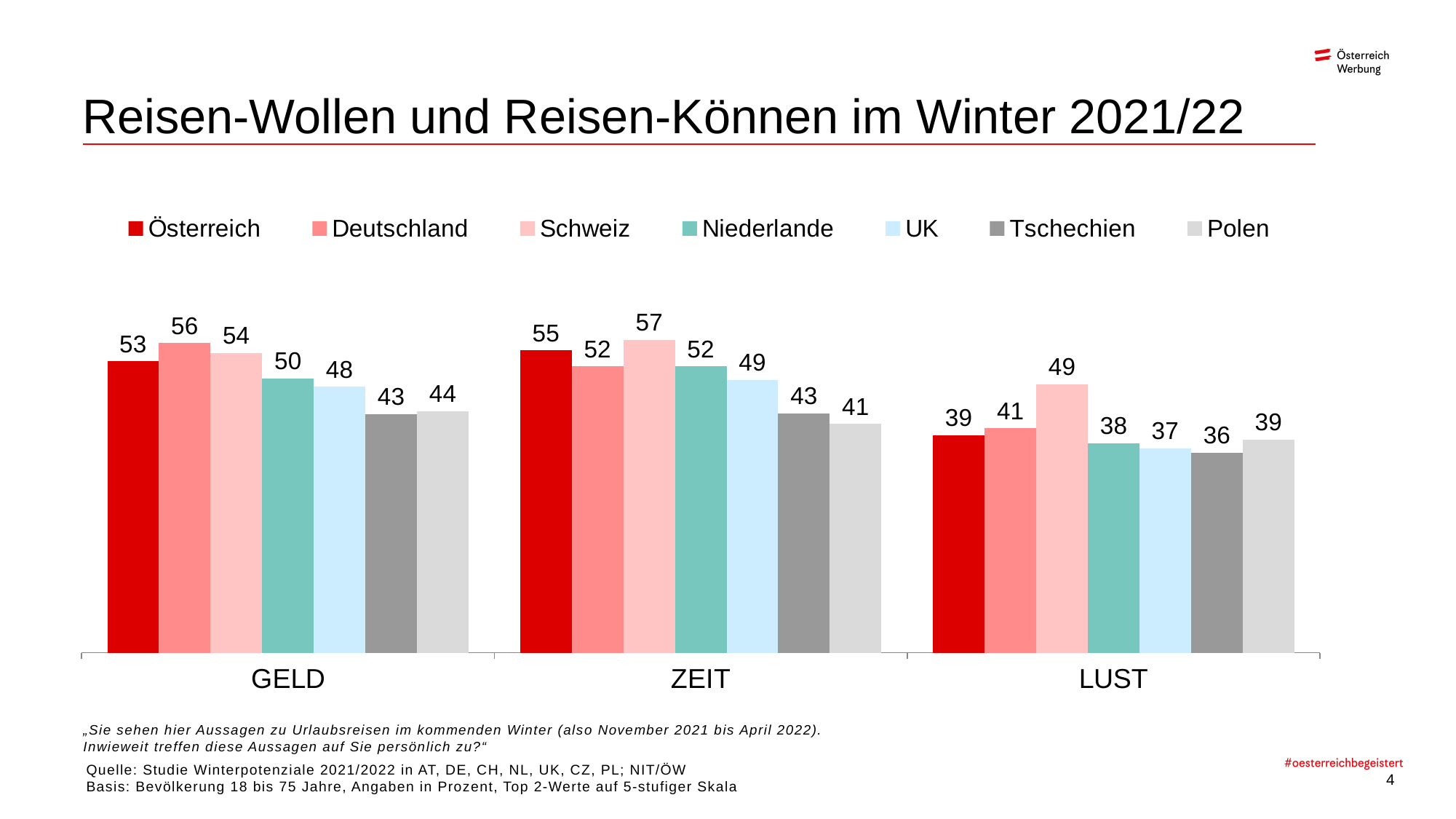
Which country has the highest value in the LUST category? Schweiz Does the value for Polen rise or fall from ZEIT to LUST? Fall How many series does the legend list? 7 What kind of chart is shown on the slide? Bar chart Which country has the lowest value in the ZEIT category? Polen What is the value for Deutschland in the GELD category? 56 How many categories are shown on the x axis? 3 Which is larger in the GELD category: the value for Niederlande or the value for UK? Niederlande What is the difference between the Österreich values for GELD and LUST? 14 What is the title of the slide? Reisen-Wollen und Reisen-Können im Winter 2021/22 What is the value for Tschechien in the LUST category? 36 What is the value for Schweiz in the ZEIT category? 57